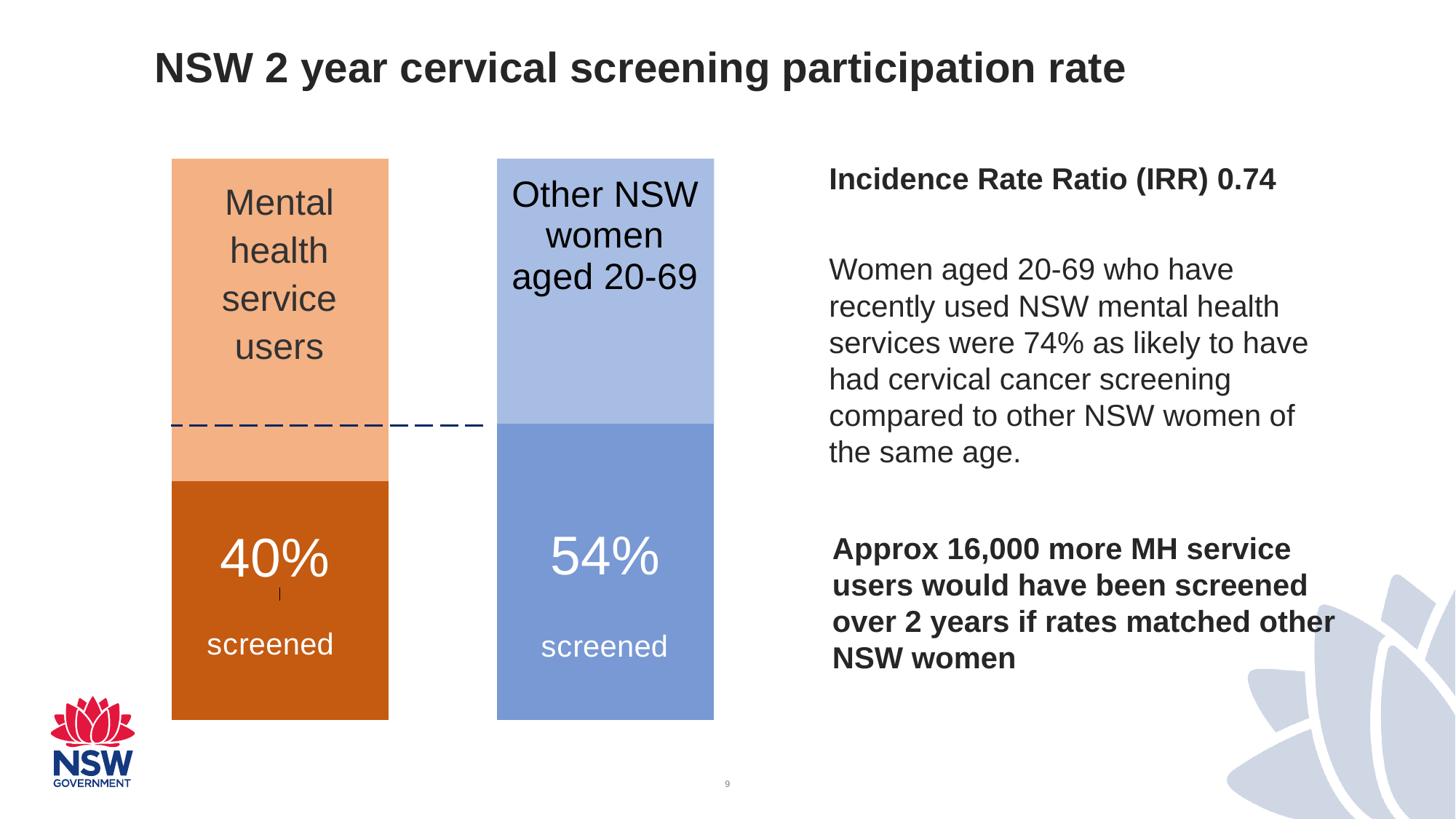
Which group has the lower screening participation rate? Mental health service users Is the screened share for mental health service users greater or less than 50%? less What kind of chart is shown on the slide? Stacked bar chart How many groups are shown as bars in the chart? 2 Is the screened share larger for mental health service users or for other NSW women aged 20-69? Other NSW women aged 20-69 What is the difference in percentage points between the screening rate of other NSW women aged 20-69 and mental health service users? 14 What colour is the bar for mental health service users? Orange What percentage of mental health service users were screened? 40% What is the Incidence Rate Ratio (IRR) stated on the slide? 0.74 What is the title of the slide containing the chart? NSW 2 year cervical screening participation rate Which group has the higher screening participation rate? Other NSW women aged 20-69 What percentage of other NSW women aged 20-69 were screened? 54%